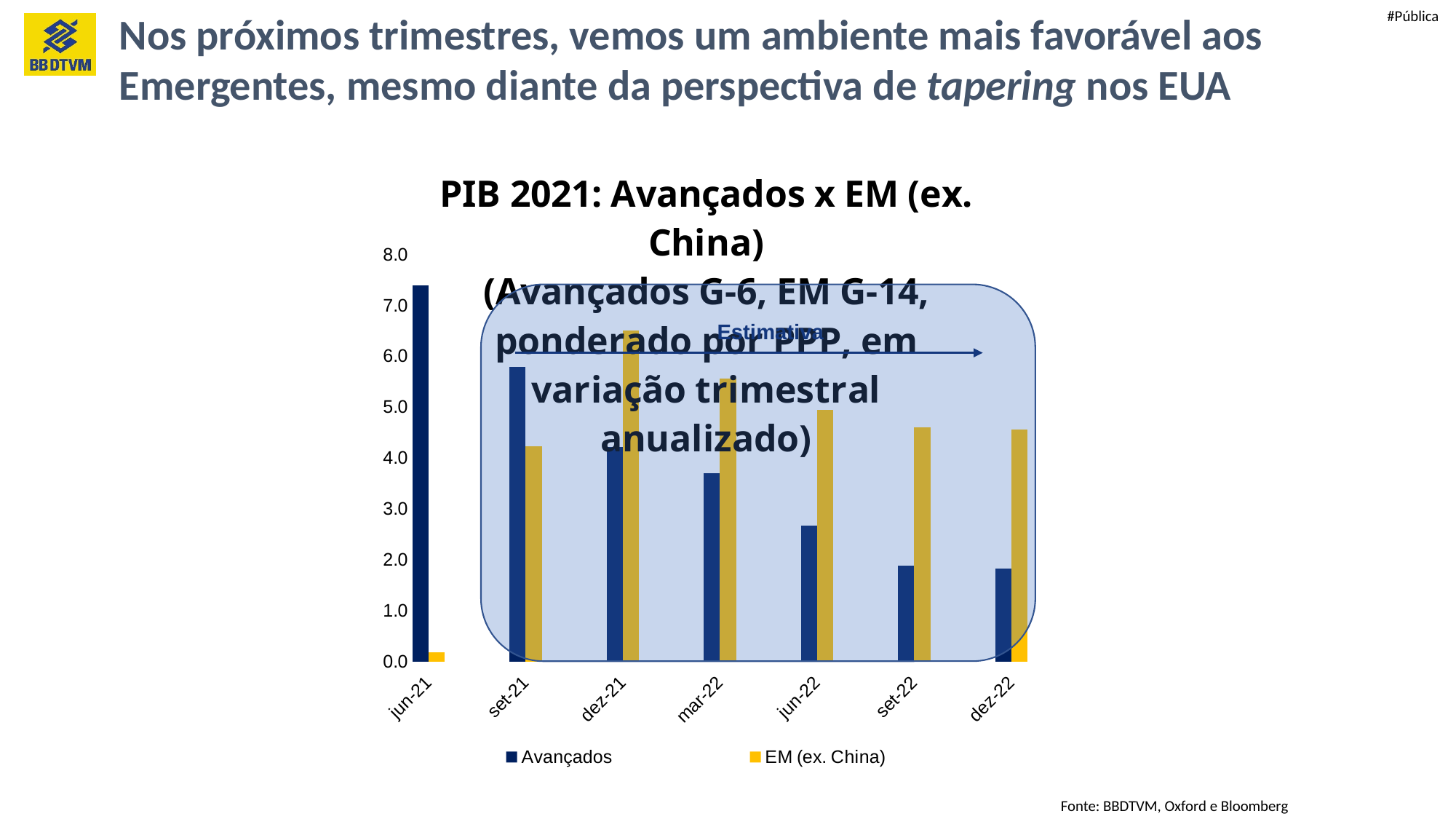
For set-21, which series has the larger value, Avançados or EM (ex. China)? Avançados Is the Avançados value for dez-22 greater or less than 2.0? less How many series does the legend list? 2 Is the EM (ex. China) value for set-22 greater or less than 4.0? greater In which period is the EM (ex. China) value highest? dez-21 Which series is shown in yellow in the legend? EM (ex. China) What kind of chart is shown on the slide? bar chart Is the Avançados value for jun-21 greater or less than 7.0? greater In which period is the Avançados value highest? jun-21 In which period is the EM (ex. China) value lowest? jun-21 How many periods are shown on the x axis? 7 Do the Avançados values rise or fall from jun-21 to dez-22? fall